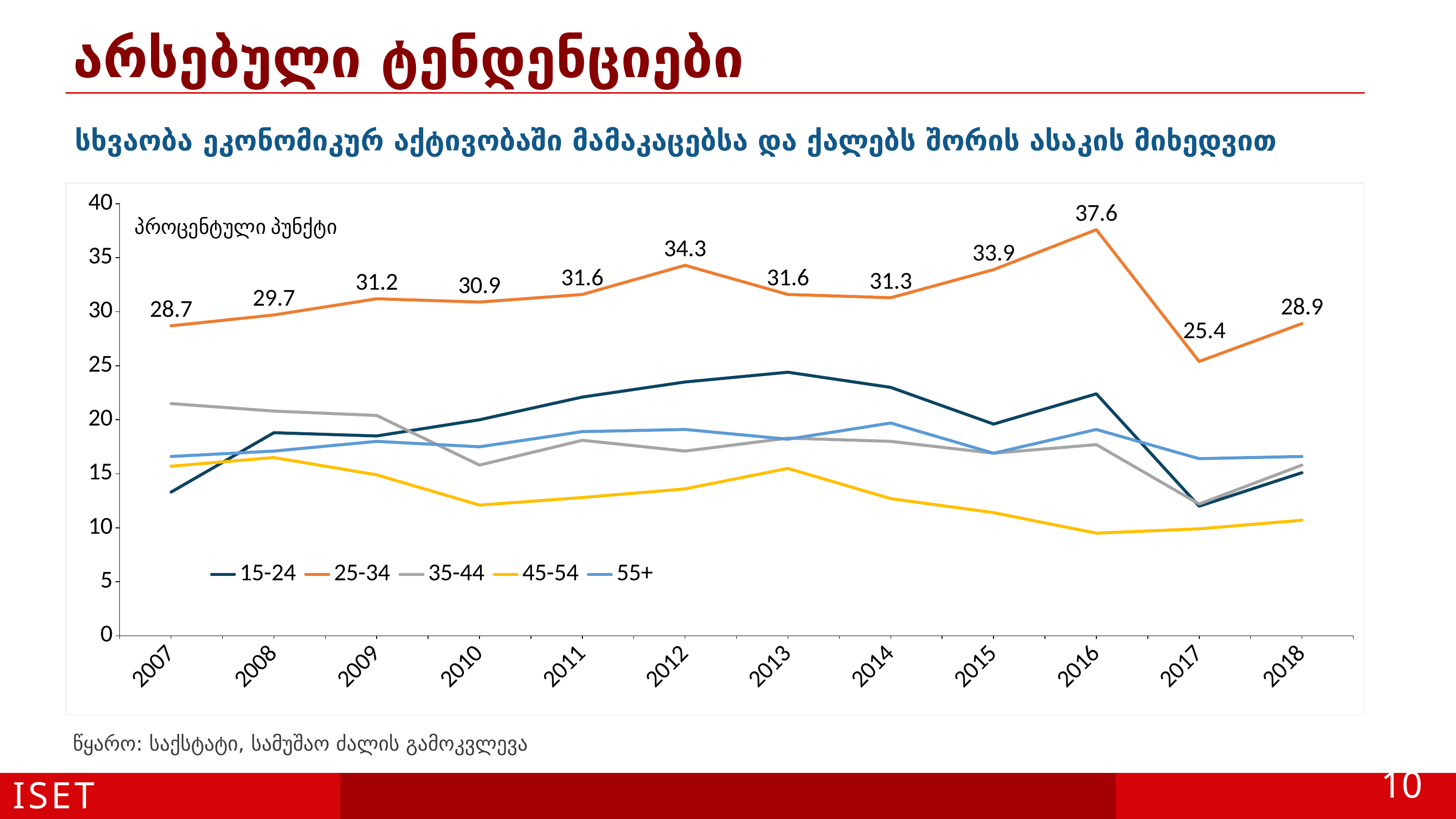
How many years are shown on the x axis? 12 What is the difference between the 25-34 series values in 2016 and 2017? 12.2 In which year does the 25-34 series reach its lowest value? 2017 In which year does the 25-34 series reach its highest value? 2016 Which is larger for the 25-34 series: the value in 2012 or the value in 2013? 2012 What type of chart is shown on the slide? line chart Which series is plotted in orange? 25-34 How many series does the legend list? 5 What is the value for the 25-34 series in 2017? 25.4 What is the value for the 25-34 series in 2016? 37.6 What is the value for the 25-34 series in 2007? 28.7 Is the value for the 45-54 series in 2016 greater or less than 10? less